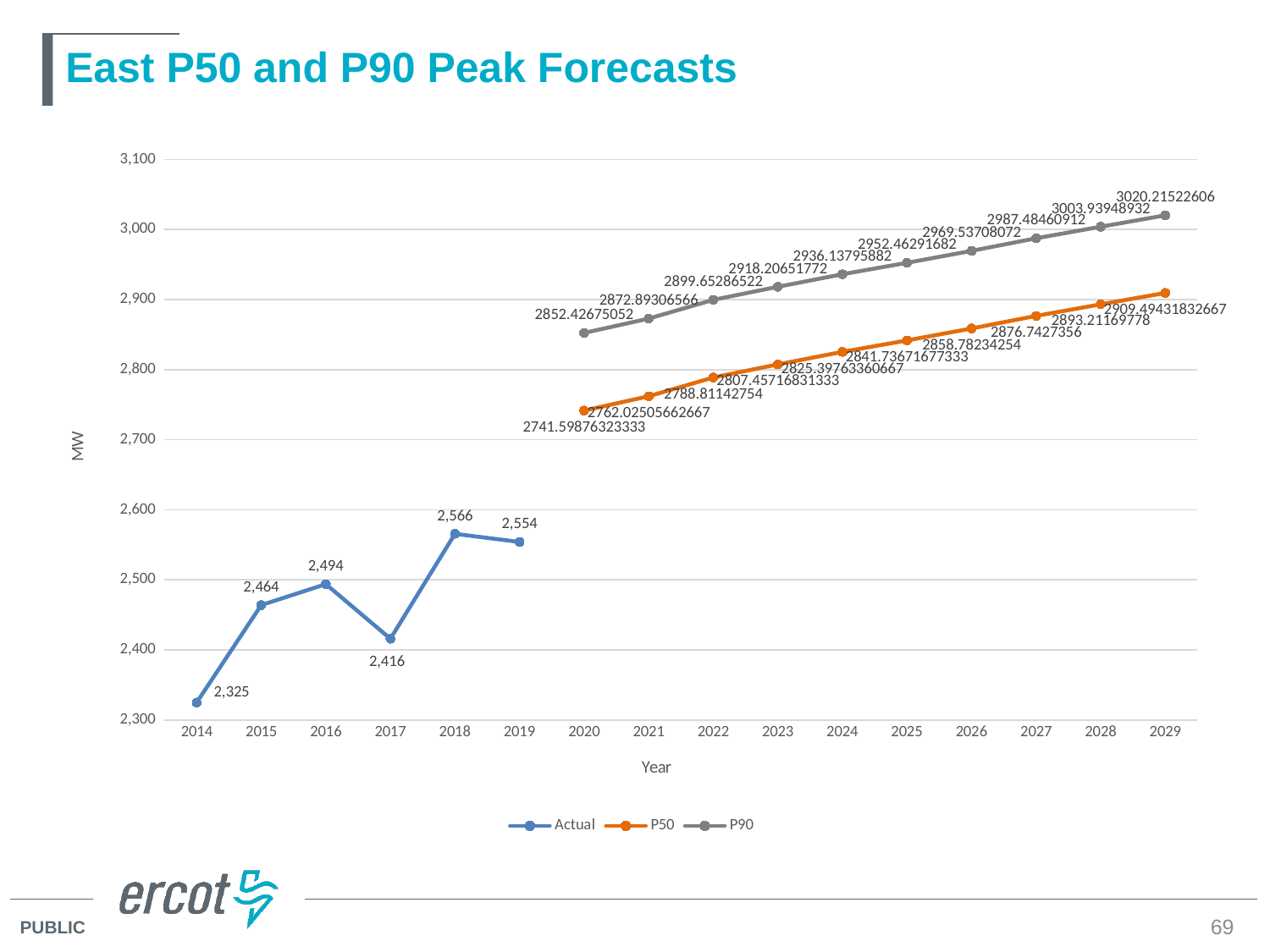
How many series does the legend list? 3 What type of chart is shown on the slide? Line chart Is the P90 value for 2029 greater or less than 3,000? greater What is the Actual value for 2017? 2,416 What is the difference between the Actual values for 2018 and 2019? 12 What is the Actual value for 2014? 2,325 Which is larger, the Actual value for 2016 or for 2015? 2016 How many years are shown on the x axis? 16 Which year has the highest Actual value? 2018 What is the Actual value for 2018? 2,566 Does the P50 series rise or fall from 2020 to 2029? Rises Which year has the lowest Actual value? 2014